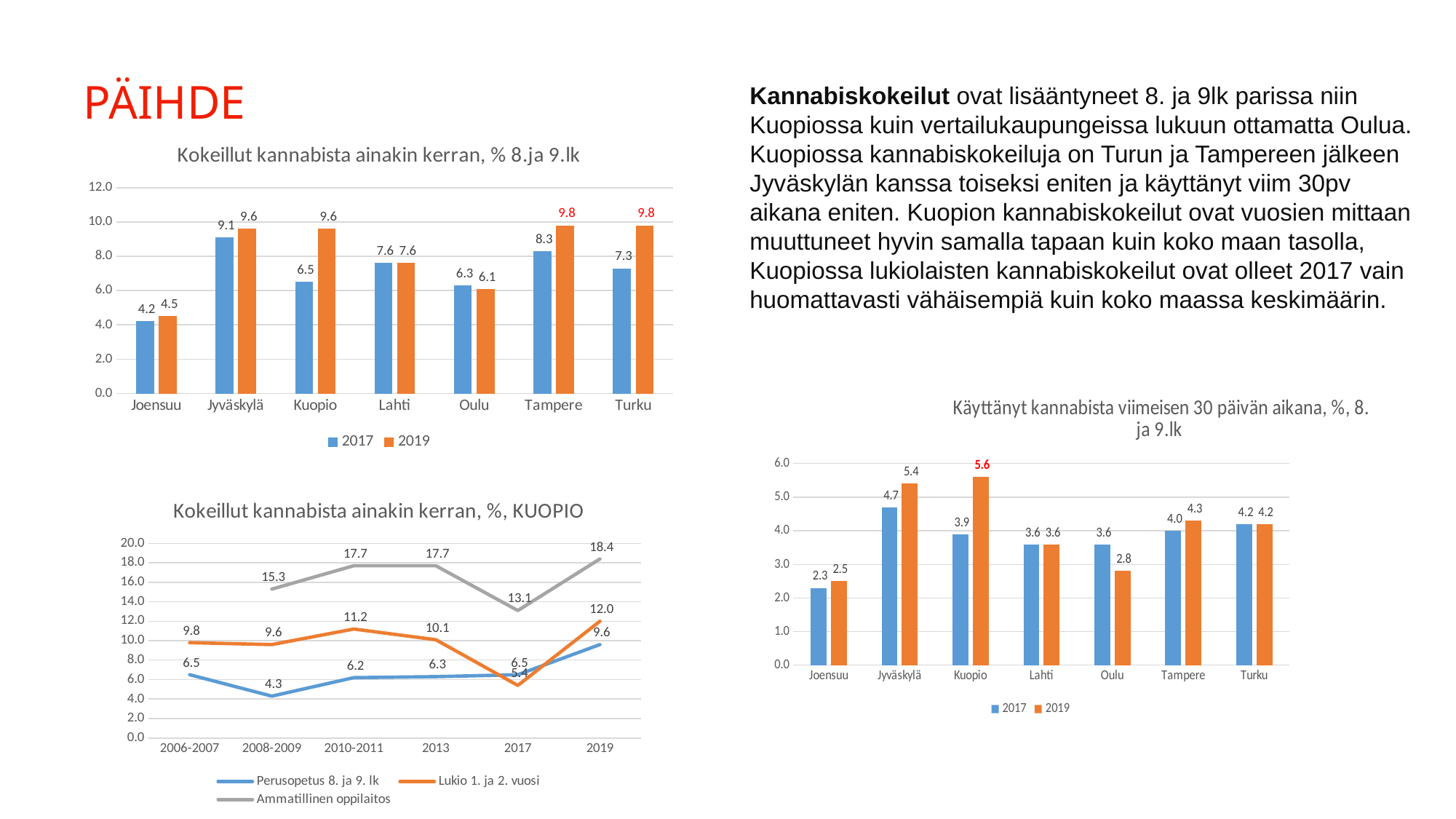
In the chart 'Käyttänyt kannabista viimeisen 30 päivän aikana, %, 8. ja 9.lk', which city has the highest 2019 value? Kuopio How many cities are shown in the chart 'Kokeillut kannabista ainakin kerran, % 8.ja 9.lk'? 7 In the chart 'Kokeillut kannabista ainakin kerran, %, KUOPIO', does the Perusopetus 8. ja 9. lk series rise or fall from 2017 to 2019? rise In the chart 'Käyttänyt kannabista viimeisen 30 päivän aikana, %, 8. ja 9.lk', what is the 2017 value for Jyväskylä? 4.7 In the chart 'Kokeillut kannabista ainakin kerran, % 8.ja 9.lk', is the 2017 value for Oulu or the 2019 value for Oulu larger? 2017 In the chart 'Kokeillut kannabista ainakin kerran, %, KUOPIO', what is the value for Ammatillinen oppilaitos in 2019? 18.4 In the chart 'Kokeillut kannabista ainakin kerran, % 8.ja 9.lk', which city has the lowest 2017 value? Joensuu In the chart 'Kokeillut kannabista ainakin kerran, % 8.ja 9.lk', what is the difference between the 2019 and 2017 values for Kuopio? 3.1 How many series does the legend of the chart 'Kokeillut kannabista ainakin kerran, %, KUOPIO' list? 3 In the chart 'Kokeillut kannabista ainakin kerran, %, KUOPIO', what is the value for Lukio 1. ja 2. vuosi in 2017? 5.4 In the chart 'Kokeillut kannabista ainakin kerran, % 8.ja 9.lk', what is the 2019 value for Kuopio? 9.6 What type of chart is 'Kokeillut kannabista ainakin kerran, %, KUOPIO'? line chart